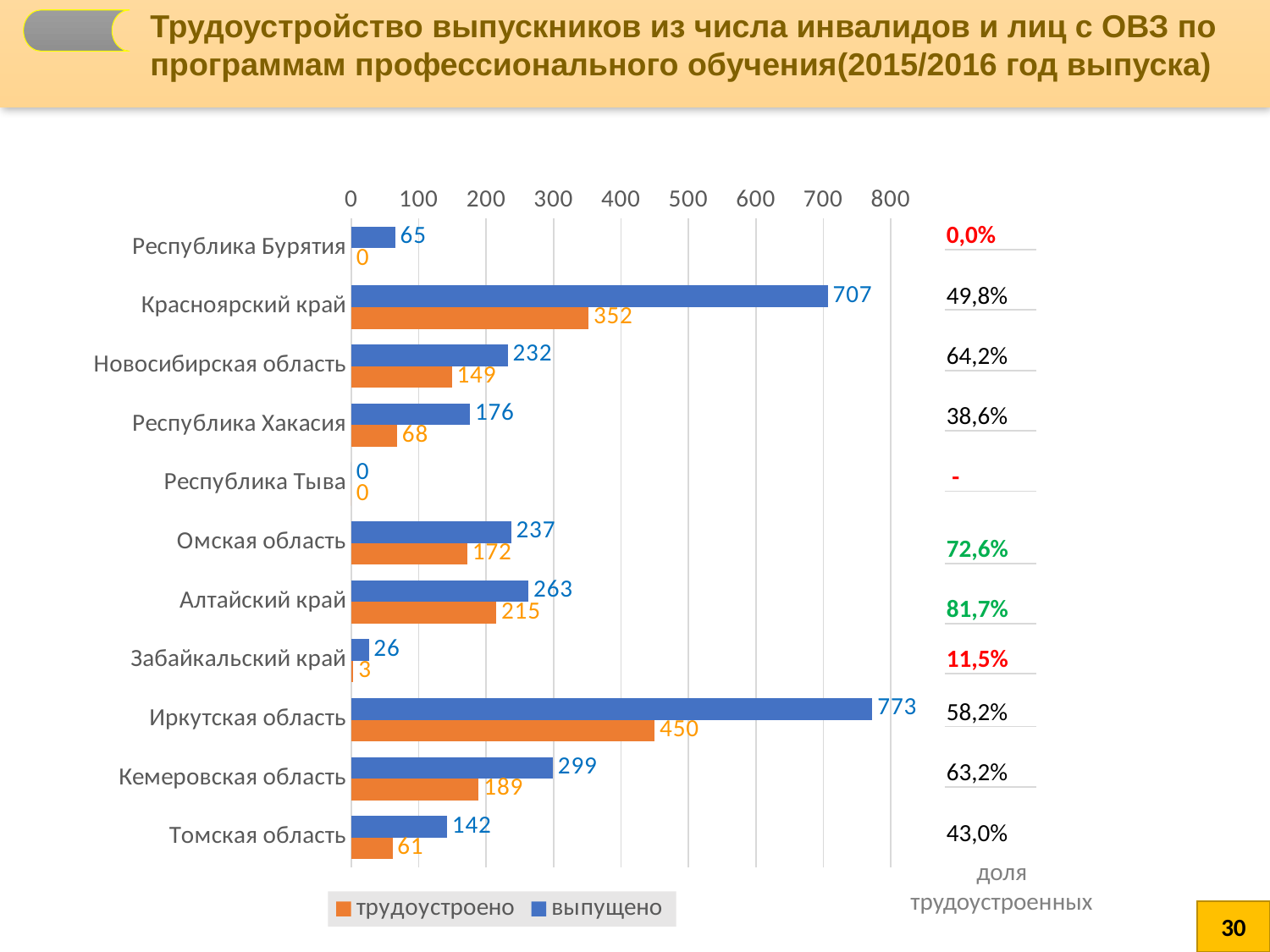
Which colour represents the series трудоустроено in the legend? orange What is the доля трудоустроенных shown for Алтайский край? 81,7% How many series does the legend list? 2 What is the difference between выпущено and трудоустроено for Кемеровская область? 110 Which is larger: трудоустроено for Омская область or трудоустроено for Новосибирская область? Омская область Which region has the highest value of выпущено? Иркутская область What is the value of выпущено for Иркутская область? 773 Which region has the lowest value of трудоустроено other than the two regions with 0? Забайкальский край What is the value of трудоустроено for Красноярский край? 352 Is the value of выпущено for Красноярский край greater or less than 700? greater How many regions are shown on the chart? 11 What kind of chart is shown on the slide? bar chart